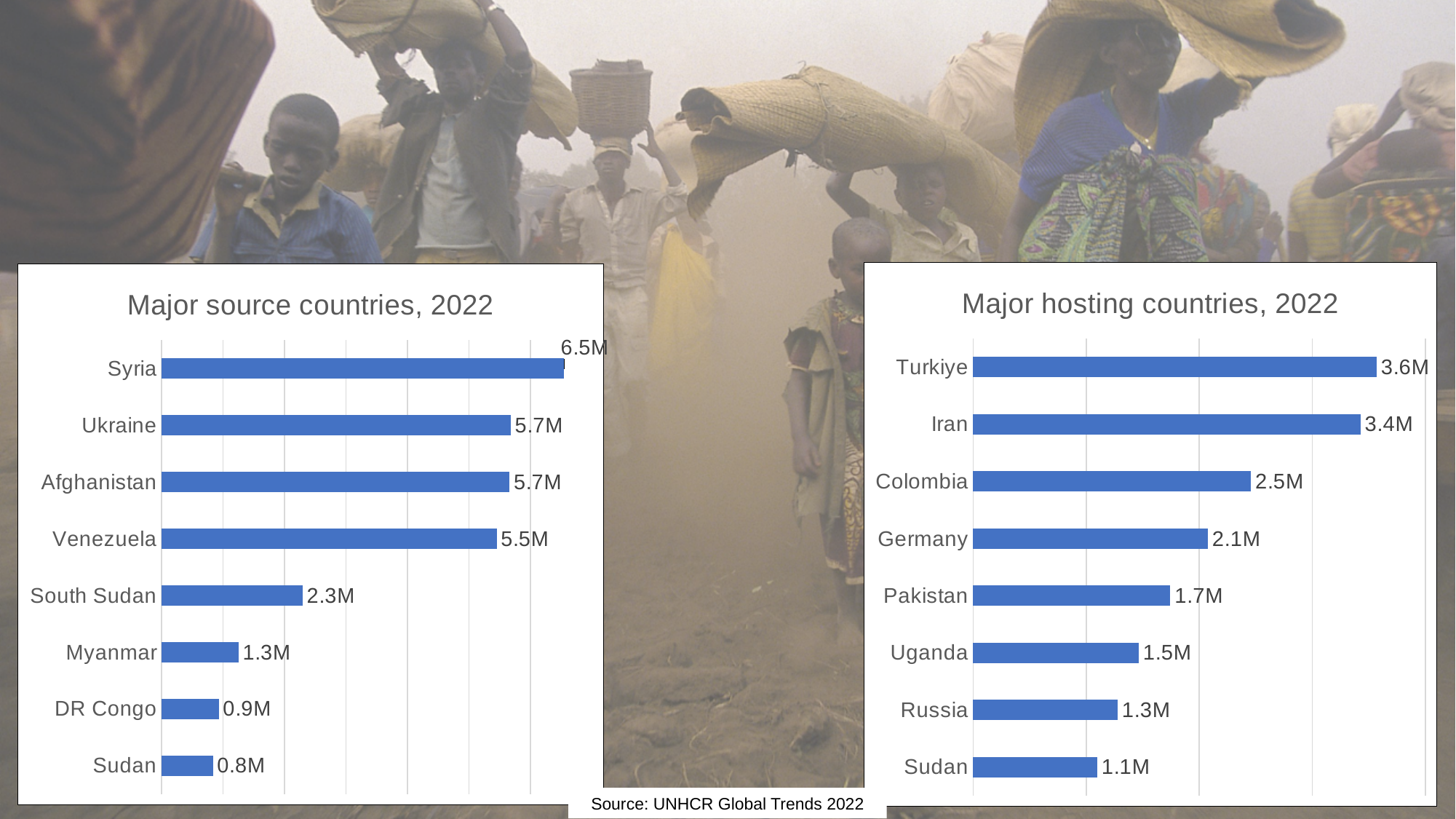
What kind of chart is the 'Major hosting countries, 2022' chart? Bar chart In the 'Major source countries, 2022' chart, what is the difference between the values for Syria and Venezuela? 1.0M How many countries are shown in the 'Major hosting countries, 2022' chart? 8 In the 'Major source countries, 2022' chart, which country has the lowest value? Sudan What is the title of the chart on the left side of the slide? Major source countries, 2022 How many countries are shown in the 'Major source countries, 2022' chart? 8 In the 'Major source countries, 2022' chart, which is larger: the value for South Sudan or the value for Myanmar? South Sudan In the 'Major hosting countries, 2022' chart, what is the difference between the values for Colombia and Pakistan? 0.8M In the 'Major hosting countries, 2022' chart, what is the value for Germany? 2.1M In the 'Major hosting countries, 2022' chart, which is larger: the value for Uganda or the value for Russia? Uganda In the 'Major hosting countries, 2022' chart, which country has the highest value? Turkiye In the 'Major source countries, 2022' chart, what is the value for Syria? 6.5M